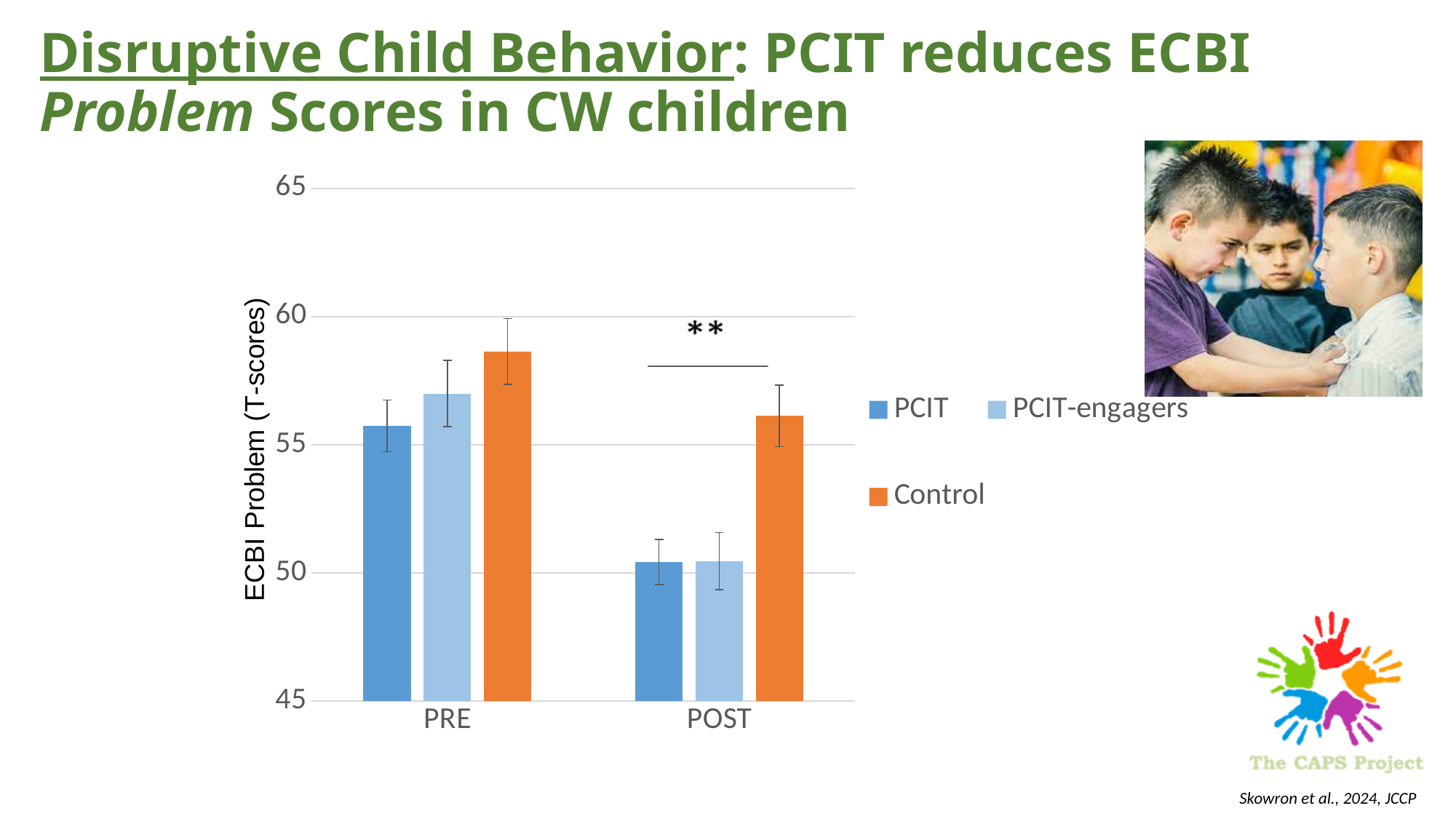
Which group has the highest ECBI Problem score at POST? Control What kind of chart is shown on the slide? bar chart What is the label on the y axis? ECBI Problem (T-scores) How many categories are shown on the x axis? 2 Is the POST value for PCIT greater or less than 55? less Which group has the highest ECBI Problem score at PRE? Control Is the PRE value for Control greater or less than 55? greater Which is larger for the PCIT group: the PRE value or the POST value? PRE Is the POST value for Control greater or less than 55? greater Do the PCIT-engagers values rise or fall from PRE to POST? fall How many series does the legend list? 3